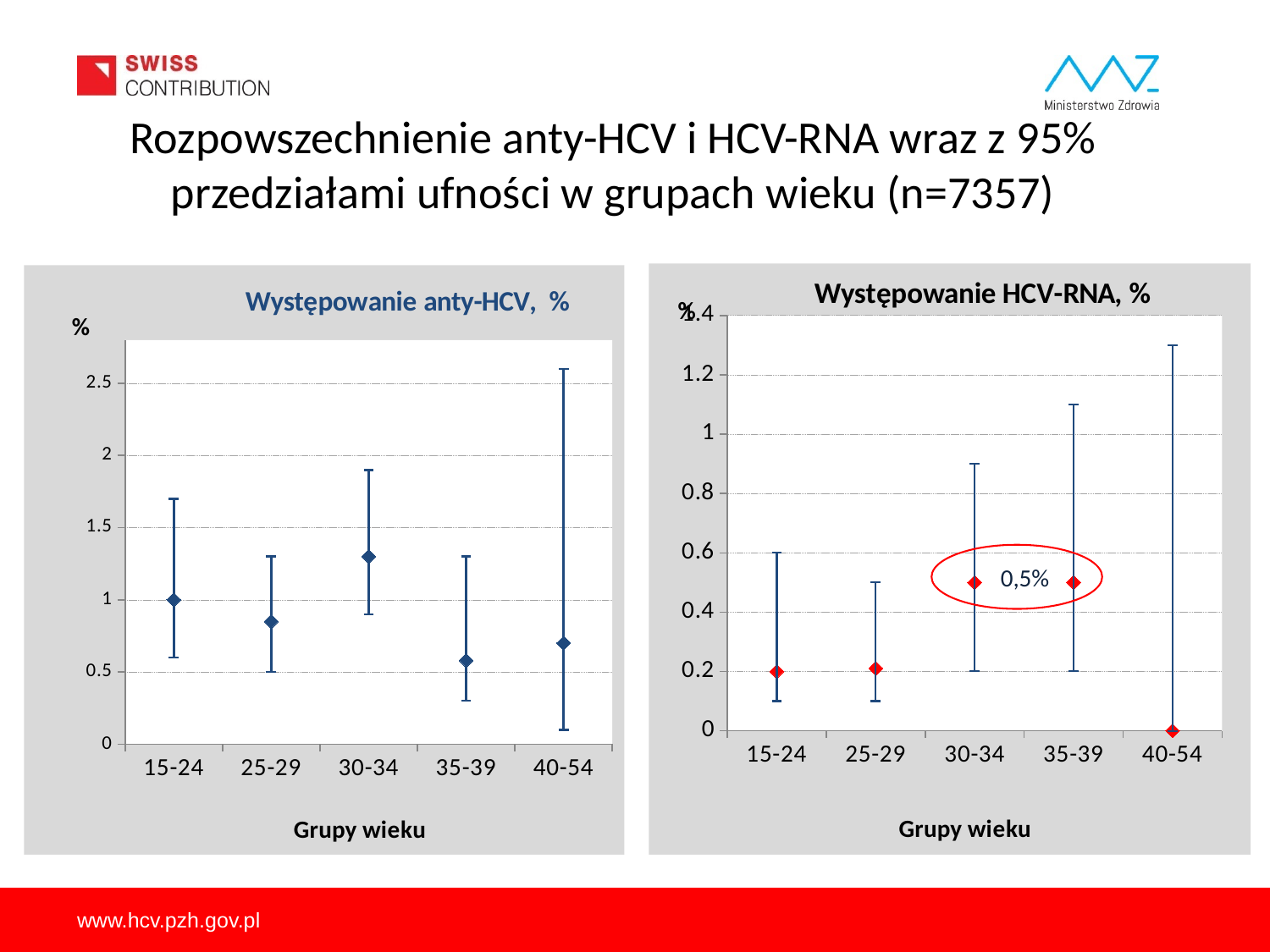
In the 'Występowanie HCV-RNA, %' chart, which age group has the lowest point estimate? 40-54 In the 'Występowanie anty-HCV, %' chart, which age group has the larger point estimate, 15-24 or 25-29? 15-24 What is the x-axis title of the 'Występowanie HCV-RNA, %' chart? Grupy wieku How many age groups are shown on the x axis of the 'Występowanie HCV-RNA, %' chart? 5 In the 'Występowanie HCV-RNA, %' chart, what value is annotated for the 30-34 and 35-39 age groups? 0,5% In the 'Występowanie anty-HCV, %' chart, which age group has the highest point estimate? 30-34 In the 'Występowanie HCV-RNA, %' chart, which age group has the larger point estimate, 15-24 or 30-34? 30-34 In the 'Występowanie anty-HCV, %' chart, which age group has the lowest point estimate? 35-39 In the 'Występowanie HCV-RNA, %' chart, what is the point estimate for the 40-54 age group? 0 What kind of chart is the 'Występowanie anty-HCV, %' chart on the left? scatter chart with error bars In the 'Występowanie anty-HCV, %' chart, is the point estimate for 35-39 greater or less than 1? less In the 'Występowanie anty-HCV, %' chart, is the point estimate for 30-34 greater or less than 1? greater